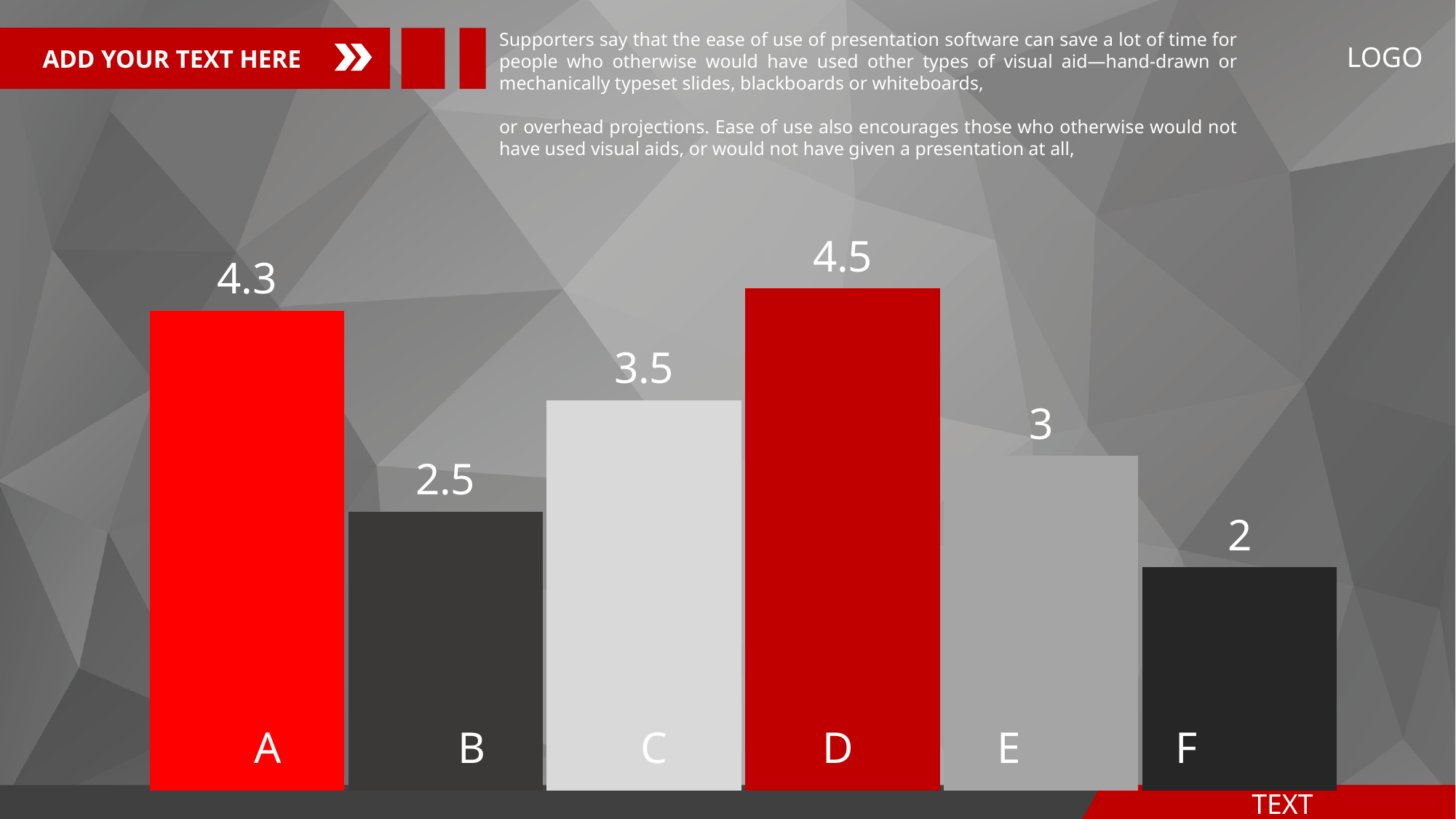
Which is larger, the value for C or the value for E? C How many categories are shown in the chart? 6 What colour is the bar for category D? dark red What is the value for category C? 3.5 What is the value for category D? 4.5 What kind of chart is shown on the slide? bar chart Which category has the highest value? D What is the difference between the values for A and E? 1.3 What is the value for category F? 2 What is the difference between the values for D and B? 2 What is the value for category A? 4.3 Which category has the lowest value? F